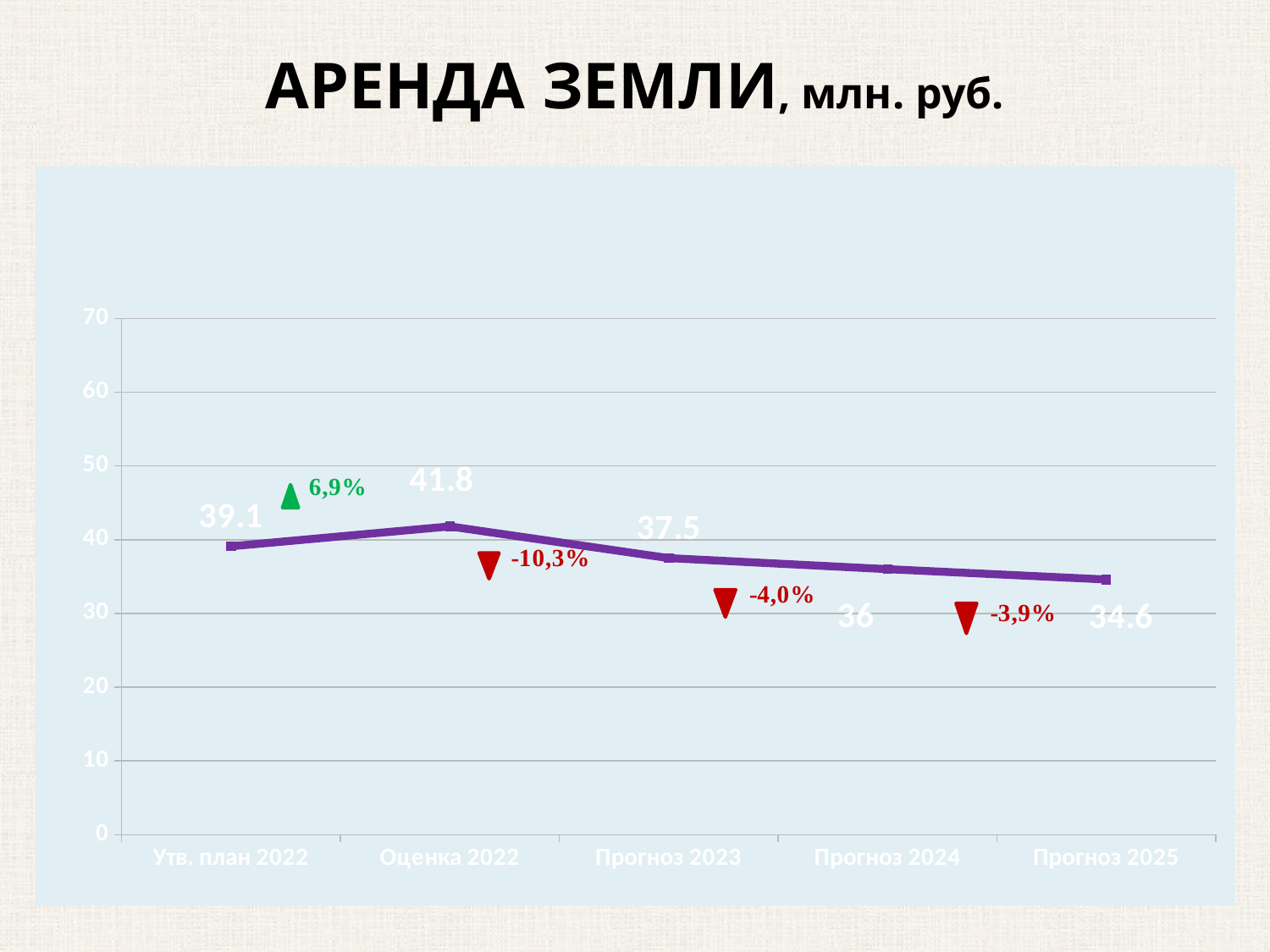
What is the difference between the values for Оценка 2022 and Прогноз 2023? 4.3 How many categories are plotted on the x axis? 5 Which is larger, the value for Утв. план 2022 or the value for Прогноз 2024? Утв. план 2022 What percentage change is annotated between Оценка 2022 and Прогноз 2023? -10,3% Which category has the lowest value? Прогноз 2025 What is the value for Прогноз 2025? 34.6 What is the value for Оценка 2022? 41.8 Do the values rise or fall from Оценка 2022 to Прогноз 2025? fall What is the value for Утв. план 2022? 39.1 What is the value for Прогноз 2024? 36 What type of chart is shown on the slide? line chart Which category has the highest value? Оценка 2022